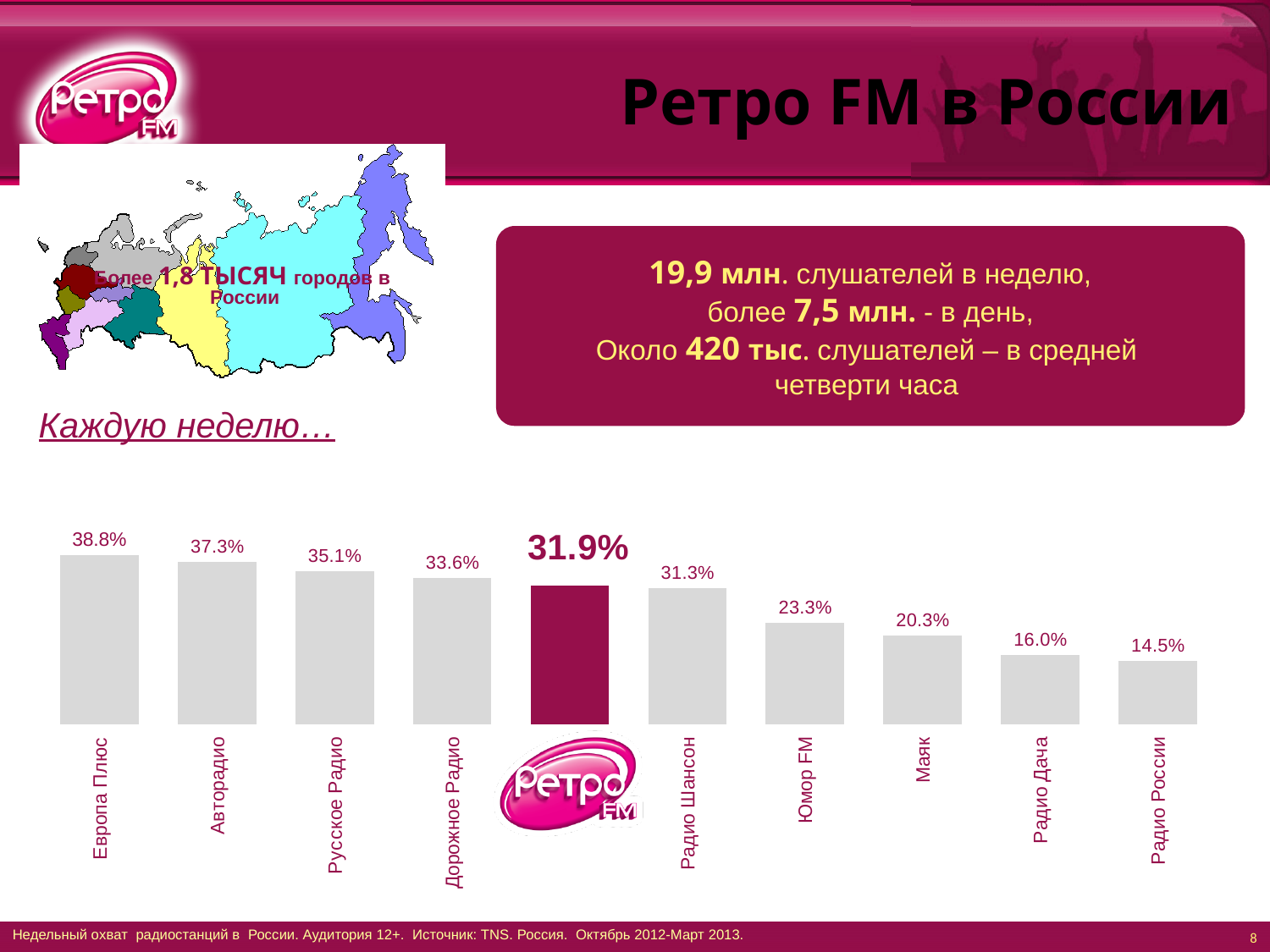
Which station has the highest value in the chart? Европа Плюс Which station has the lowest value in the chart? Радио России What is the value shown for Европа Плюс? 38.8% Which has a larger value, Юмор FM or Радио Дача? Юмор FM What is the difference between the values for Европа Плюс and Радио России? 24.3% What is the value shown for Маяк? 20.3% What is the value shown for Радио Шансон? 31.3% What is the value shown for the highlighted Ретро FM bar? 31.9% Do the values rise or fall from left to right across the chart? Fall What kind of chart is shown on the slide? Bar chart What is the difference between the values for Ретро FM and Радио Шансон? 0.6% How many stations are shown in the bar chart? 10